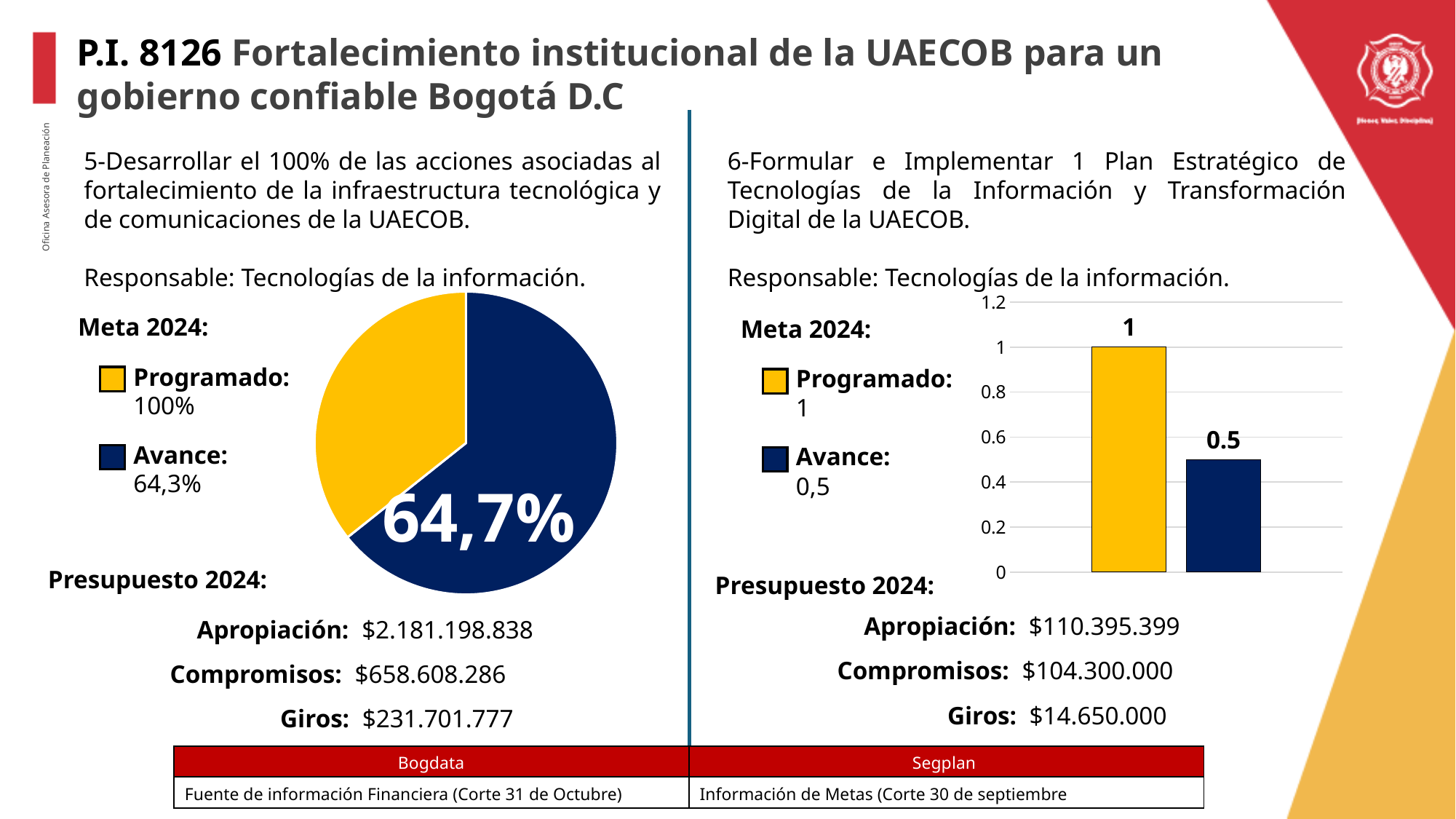
How many entries does the legend next to the pie chart on the left list? 2 In the pie chart on the left, which slice is larger, the dark blue one or the yellow one? dark blue In the bar chart on the right, is the Avance bar greater or less than 0.6? less What type of chart is shown on the right side of the slide? bar chart What percentage is printed on the dark blue slice of the pie chart on the left? 64,7% In the bar chart on the right, which bar is taller, Programado or Avance? Programado How many bars are plotted in the bar chart on the right? 2 In the bar chart on the right, what is the value of the yellow Programado bar? 1 In the bar chart on the right, what is the value of the dark blue Avance bar? 0.5 In the bar chart on the right, what is the difference between the Programado bar and the Avance bar? 0.5 What type of chart is shown on the left side of the slide? pie chart In the bar chart on the right, what is the highest value shown on the vertical axis? 1.2